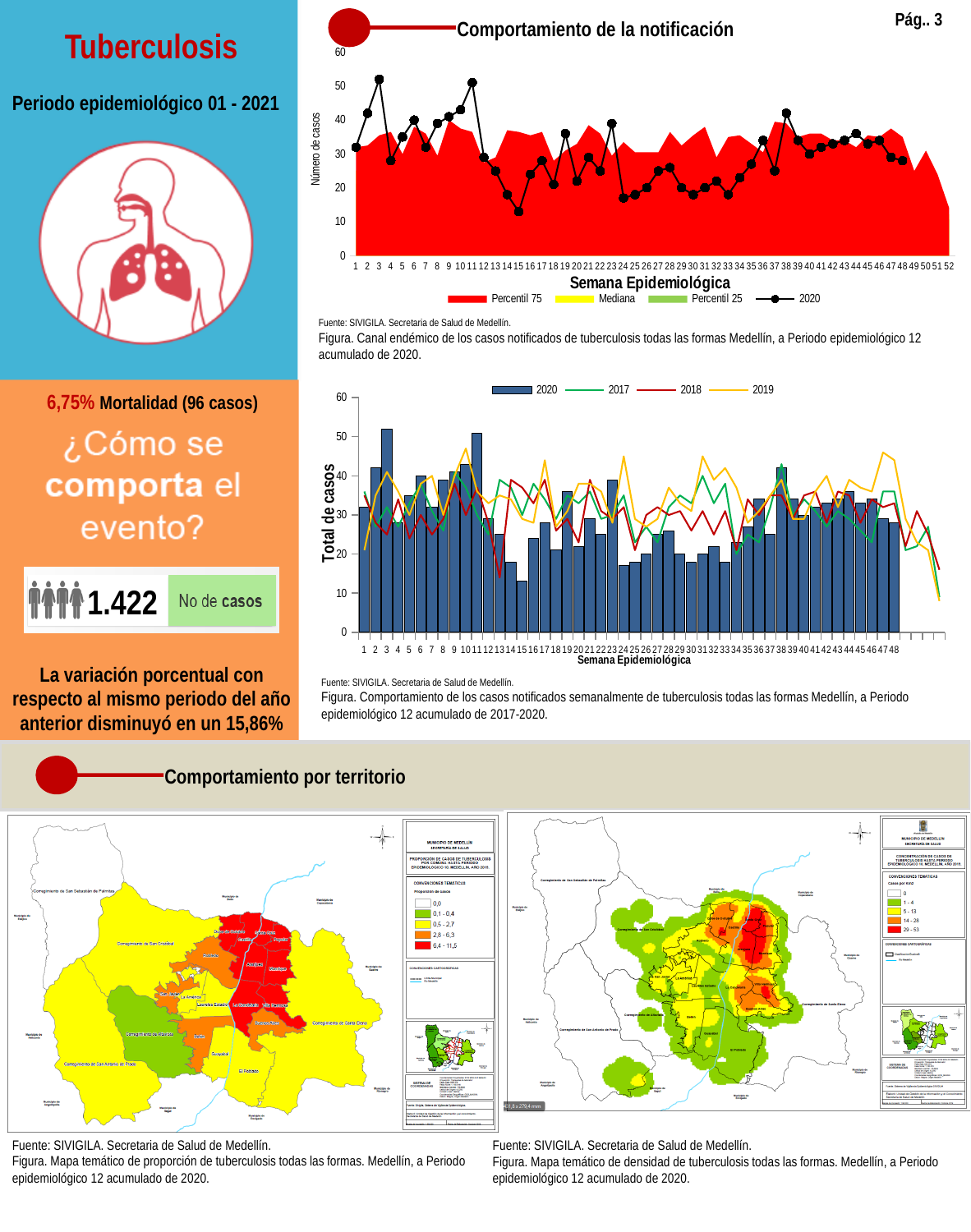
In the chart titled 'Comportamiento de la notificación', how many entries does the legend list? 4 In the second chart (with the 'Total de casos' y axis), how many epidemiological weeks are labelled on the x axis? 48 In the chart titled 'Comportamiento de la notificación', at which epidemiological week does the 2020 line reach its lowest value? 15 In the second chart (with the 'Total de casos' y axis), how many series does the legend list? 4 In the chart titled 'Comportamiento de la notificación', what is the label of the y axis? Número de casos In the second chart (with the 'Total de casos' y axis), what kind of chart is used to plot the 2020 series? Bar chart In the chart titled 'Comportamiento de la notificación', how many epidemiological weeks are labelled on the x axis? 52 In the chart titled 'Comportamiento de la notificación', is the 2020 value for week 3 greater or less than 40? greater In the chart titled 'Comportamiento de la notificación', is the 2020 value for week 15 greater or less than 20? less In the second chart (with the 'Total de casos' y axis), is the 2020 value for week 15 greater or less than 20? less In the second chart (with the 'Total de casos' y axis), which is larger for 2020: the value for week 2 or the value for week 1? Week 2 In the chart titled 'Comportamiento de la notificación', which colour is used for the Percentil 75 series? Red